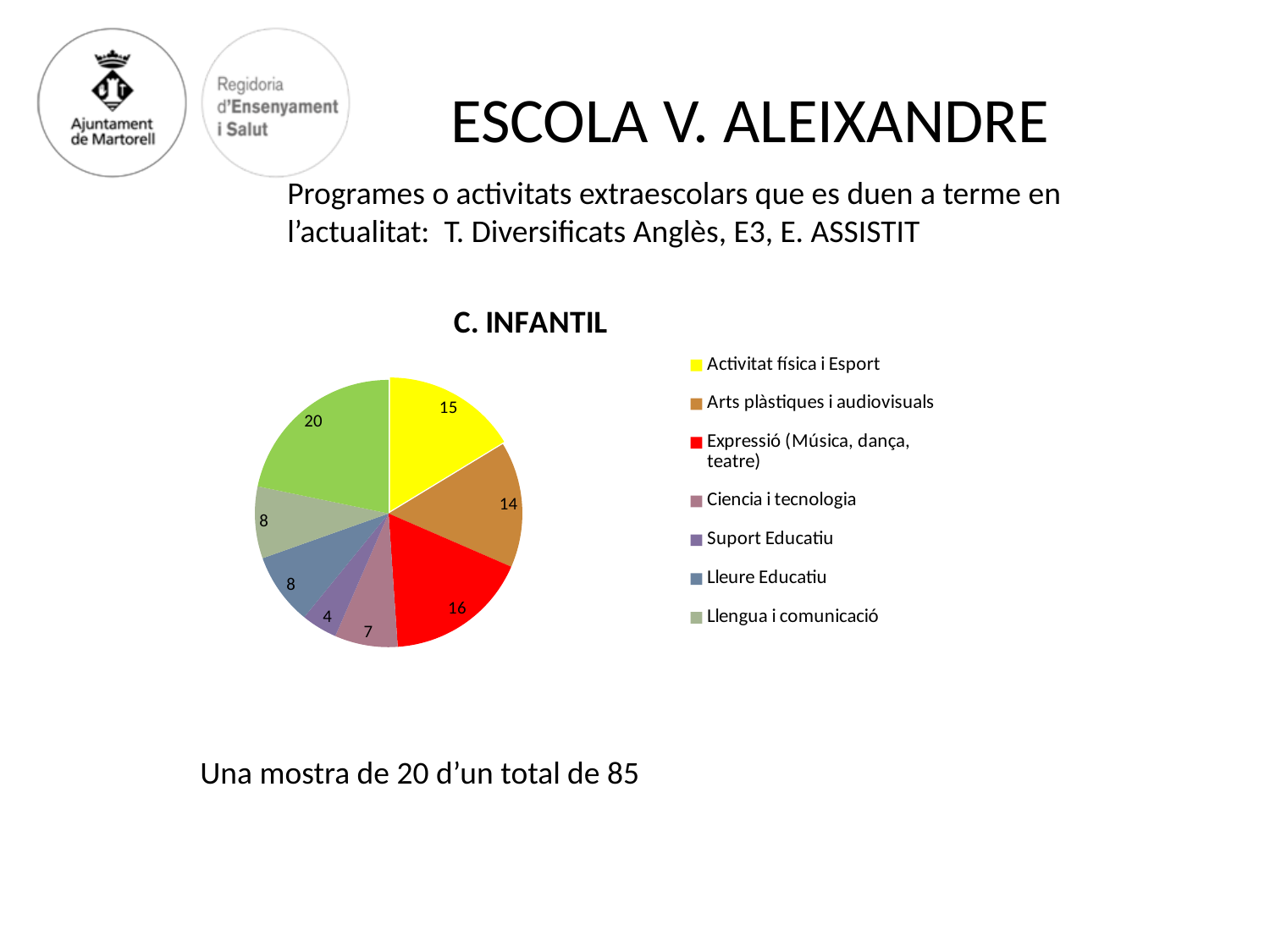
What is the title of the pie chart on the slide? C. INFANTIL What value is shown for Expressió (Música, dança, teatre) in the C. INFANTIL chart? 16 What value is shown for Suport Educatiu in the C. INFANTIL chart? 4 What value is shown for Ciencia i tecnologia in the C. INFANTIL chart? 7 What value is shown for the Activitat física i Esport slice in the C. INFANTIL pie chart? 15 Which legend category has the smallest slice in the C. INFANTIL pie chart? Suport Educatiu What type of chart is used for C. INFANTIL? Pie chart How many entries does the legend of the C. INFANTIL chart list? 7 What value is shown for Lleure Educatiu in the C. INFANTIL chart? 8 What is the difference between the values for Expressió (Música, dança, teatre) and Arts plàstiques i audiovisuals in the C. INFANTIL chart? 2 What value is shown for Arts plàstiques i audiovisuals in the C. INFANTIL chart? 14 Which is larger in the C. INFANTIL chart: Activitat física i Esport or Arts plàstiques i audiovisuals? Activitat física i Esport